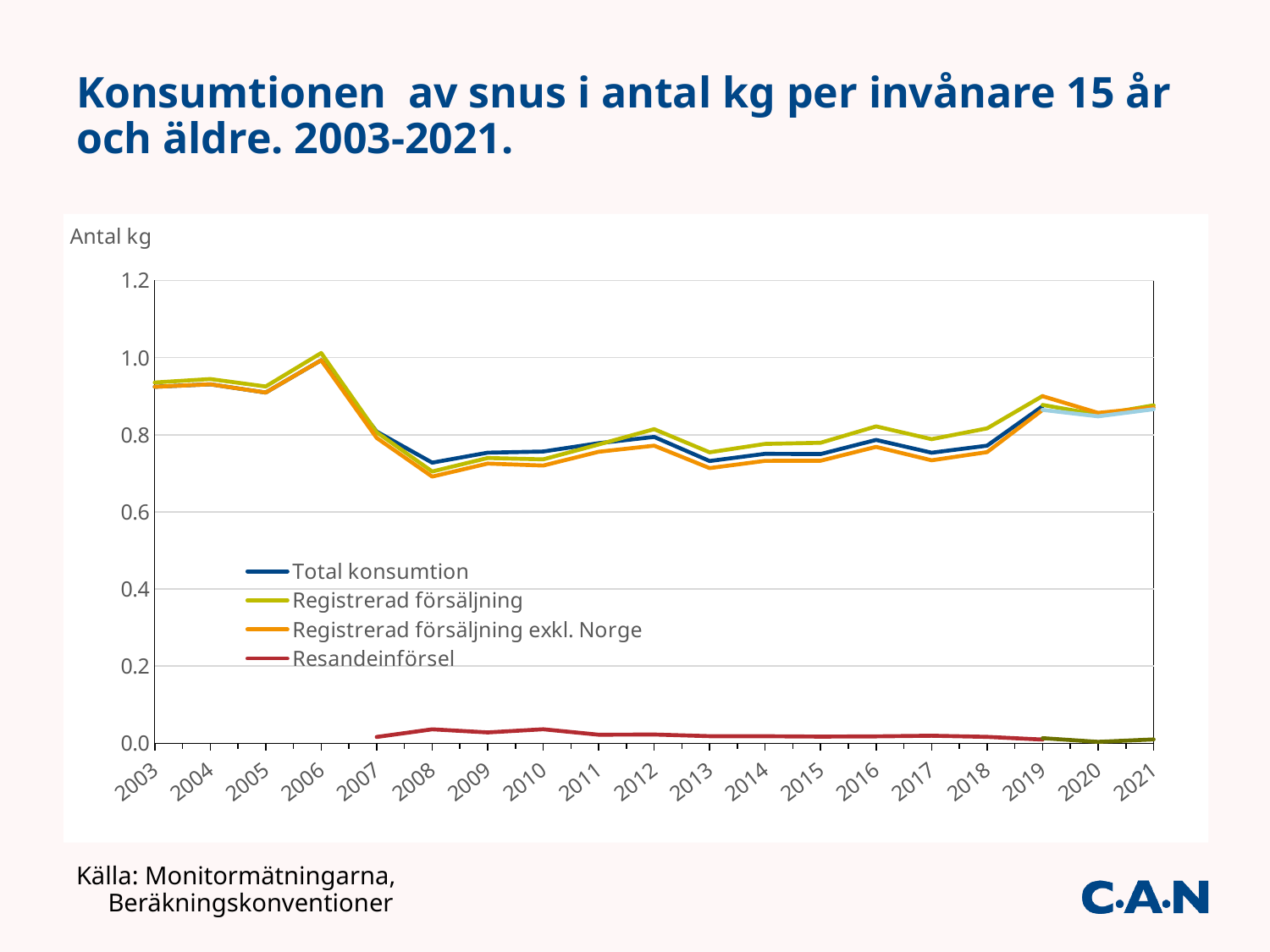
Is the value for Total konsumtion in 2006 greater or less than 0.8? greater In which year does the Registrerad försäljning line reach its highest value? 2006 Which series has the lowest values throughout the chart? Resandeinförsel What kind of chart is shown on the slide? line chart Does the Total konsumtion line rise or fall between 2006 and 2008? fall Is the value for Registrerad försäljning exkl. Norge in 2008 greater or less than 0.8? less How many series does the legend list? 4 Is the value for Resandeinförsel in 2010 greater or less than 0.2? less Which series has the larger value in 2012, Registrerad försäljning or Resandeinförsel? Registrerad försäljning What is the label on the y axis of the chart? Antal kg What is the first year shown on the x axis? 2003 How many years are shown along the x axis? 19